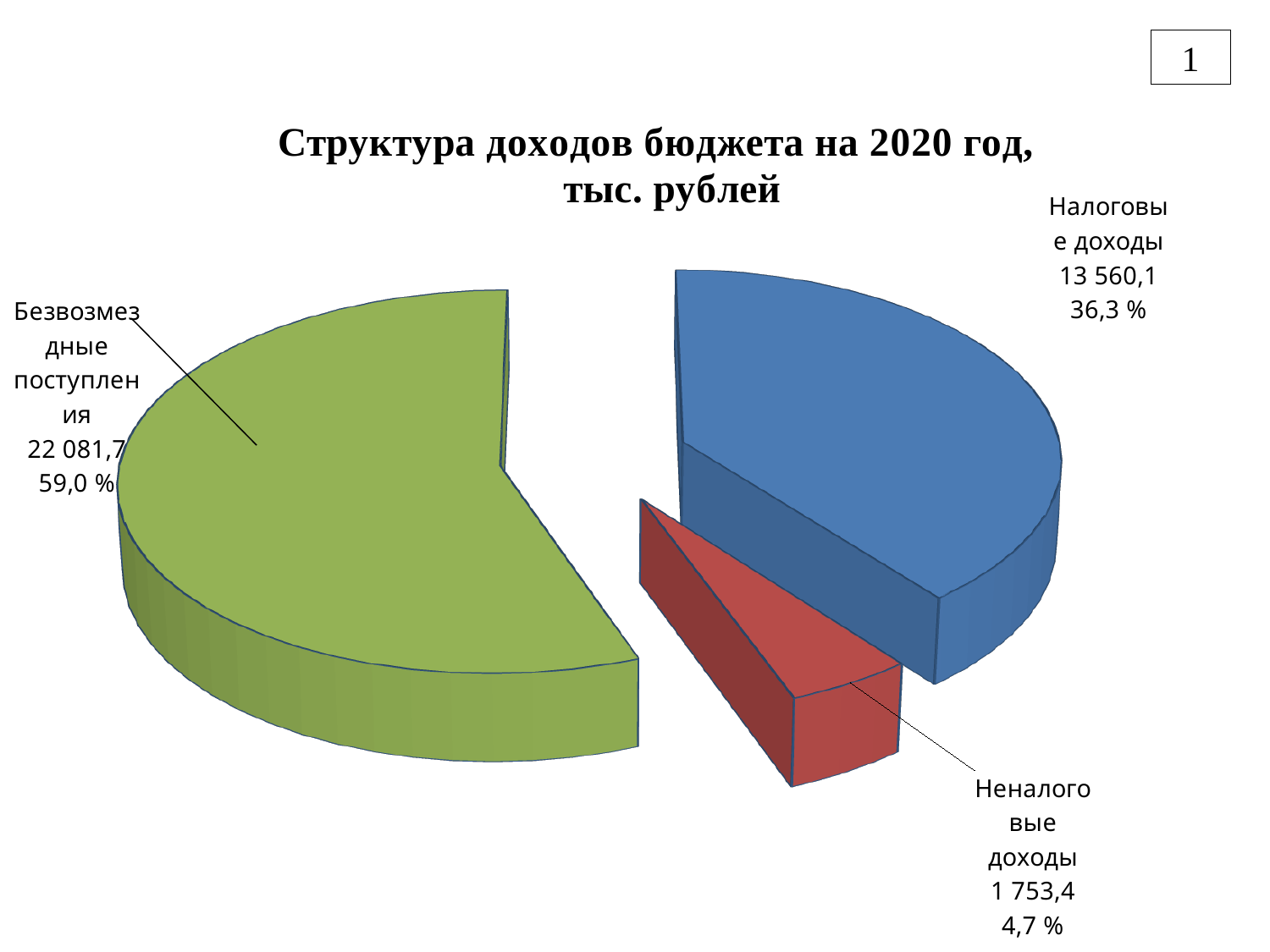
How many categories are shown in the pie chart? 3 What is the title of the chart? Структура доходов бюджета на 2020 год, тыс. рублей What kind of chart is shown on the slide? Pie chart Which category has the largest slice of the pie? Безвозмездные поступления What is the difference between the values for Безвозмездные поступления and Налоговые доходы? 8 521,6 What is the value for Безвозмездные поступления? 22 081,7 What share of the pie does Налоговые доходы represent? 36,3 % What share of the pie does Неналоговые доходы represent? 4,7 % What is the value for Налоговые доходы? 13 560,1 Which is larger, the value for Налоговые доходы or the value for Неналоговые доходы? Налоговые доходы What is the value for Неналоговые доходы? 1 753,4 Which category has the smallest slice of the pie? Неналоговые доходы